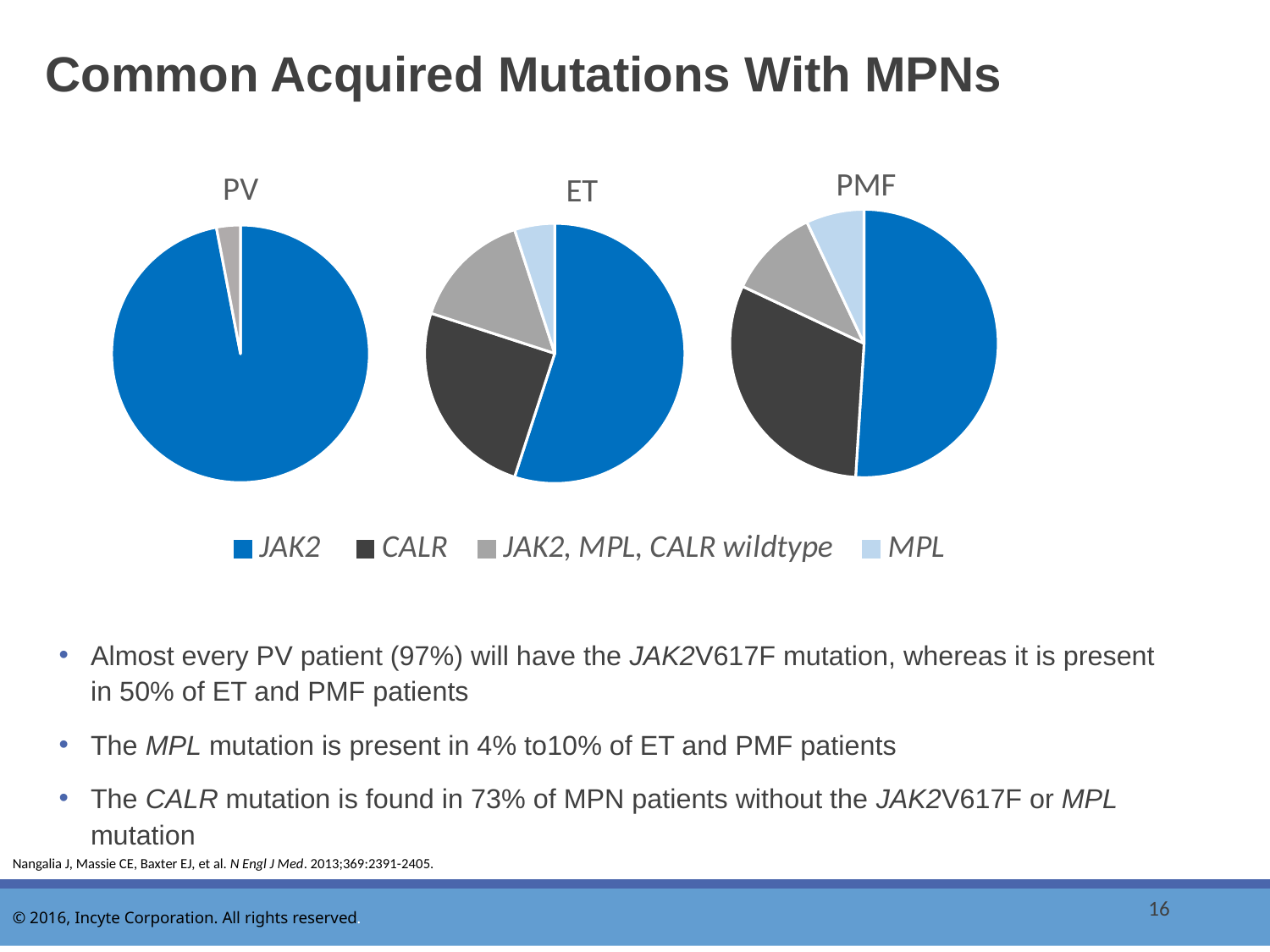
What kind of chart is used for the PV, ET and PMF data on this slide? Pie chart How many series does the legend list? 4 In the PMF pie chart, which category has the smallest slice? MPL In the ET pie chart, which slice is larger, JAK2 or CALR? JAK2 In the ET pie chart, which category has the smallest slice? MPL How many pie charts are shown on the slide? 3 In the ET pie chart, which category has the largest slice? JAK2 In the PMF pie chart, which category has the largest slice? JAK2 What is the title of the pie chart on the far right? PMF In the PMF pie chart, which slice is larger, CALR or JAK2, MPL, CALR wildtype? CALR Which colour represents JAK2 in the legend? Blue In the PV pie chart, which category has the largest slice? JAK2